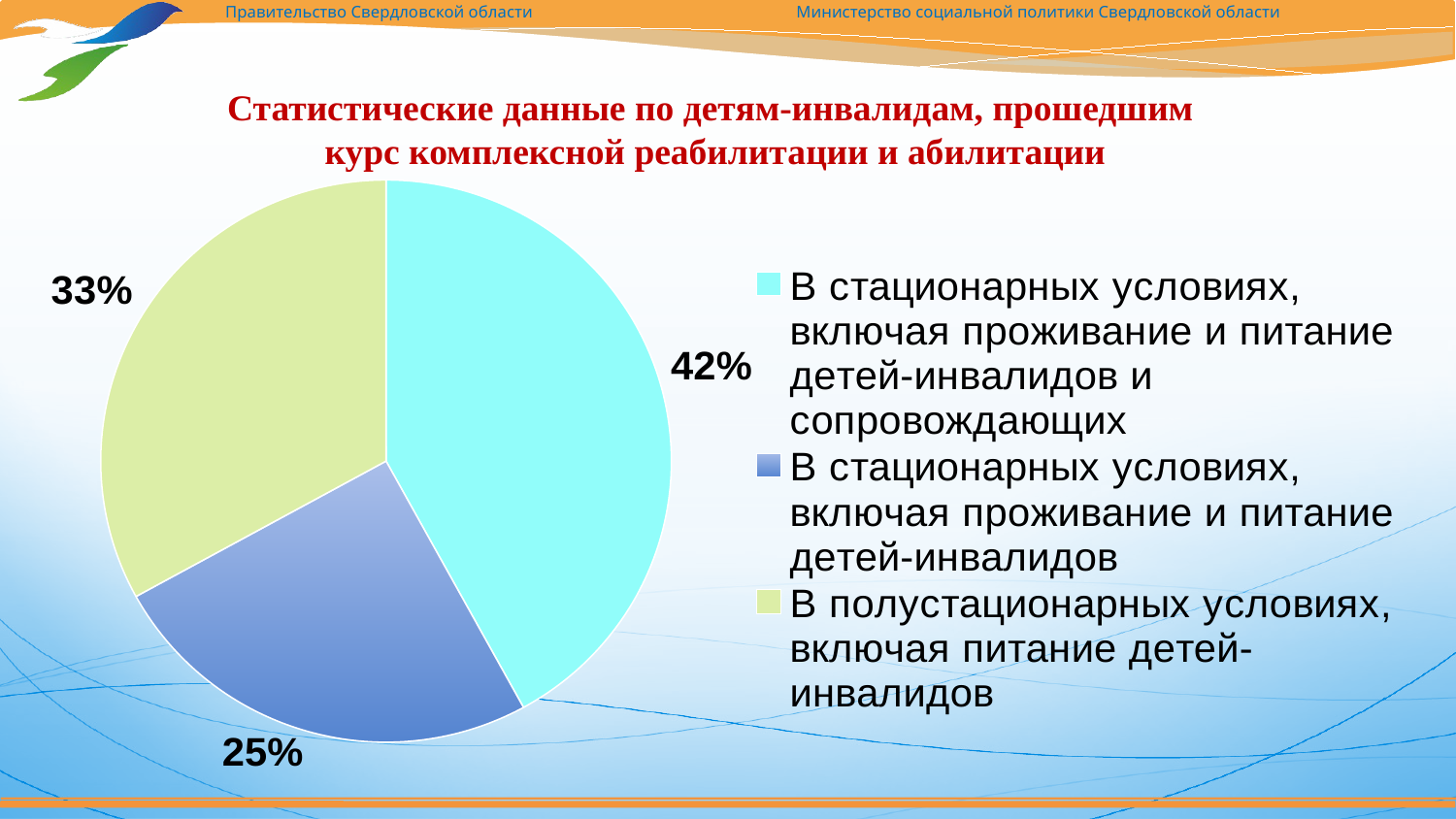
What is the title of the chart on the slide? Статистические данные по детям-инвалидам, прошедшим курс комплексной реабилитации и абилитации What kind of chart is shown on the slide? pie chart What share of the pie is labelled for 'В полустационарных условиях, включая питание детей-инвалидов'? 33% What colour is the slice representing 'В полустационарных условиях, включая питание детей-инвалидов'? light green What share of the pie is labelled for 'В стационарных условиях, включая проживание и питание детей-инвалидов и сопровождающих'? 42% What is the difference in percentage points between the largest slice (42%) and the smallest slice (25%)? 17 Which category has the smallest slice of the pie? В стационарных условиях, включая проживание и питание детей-инвалидов Which is larger: the slice for 'В полустационарных условиях, включая питание детей-инвалидов' or the slice for 'В стационарных условиях, включая проживание и питание детей-инвалидов'? В полустационарных условиях, включая питание детей-инвалидов What share of the pie is labelled for 'В стационарных условиях, включая проживание и питание детей-инвалидов'? 25% Which category has the largest slice of the pie? В стационарных условиях, включая проживание и питание детей-инвалидов и сопровождающих How many entries does the legend list? 3 How many slices does the pie chart have? 3